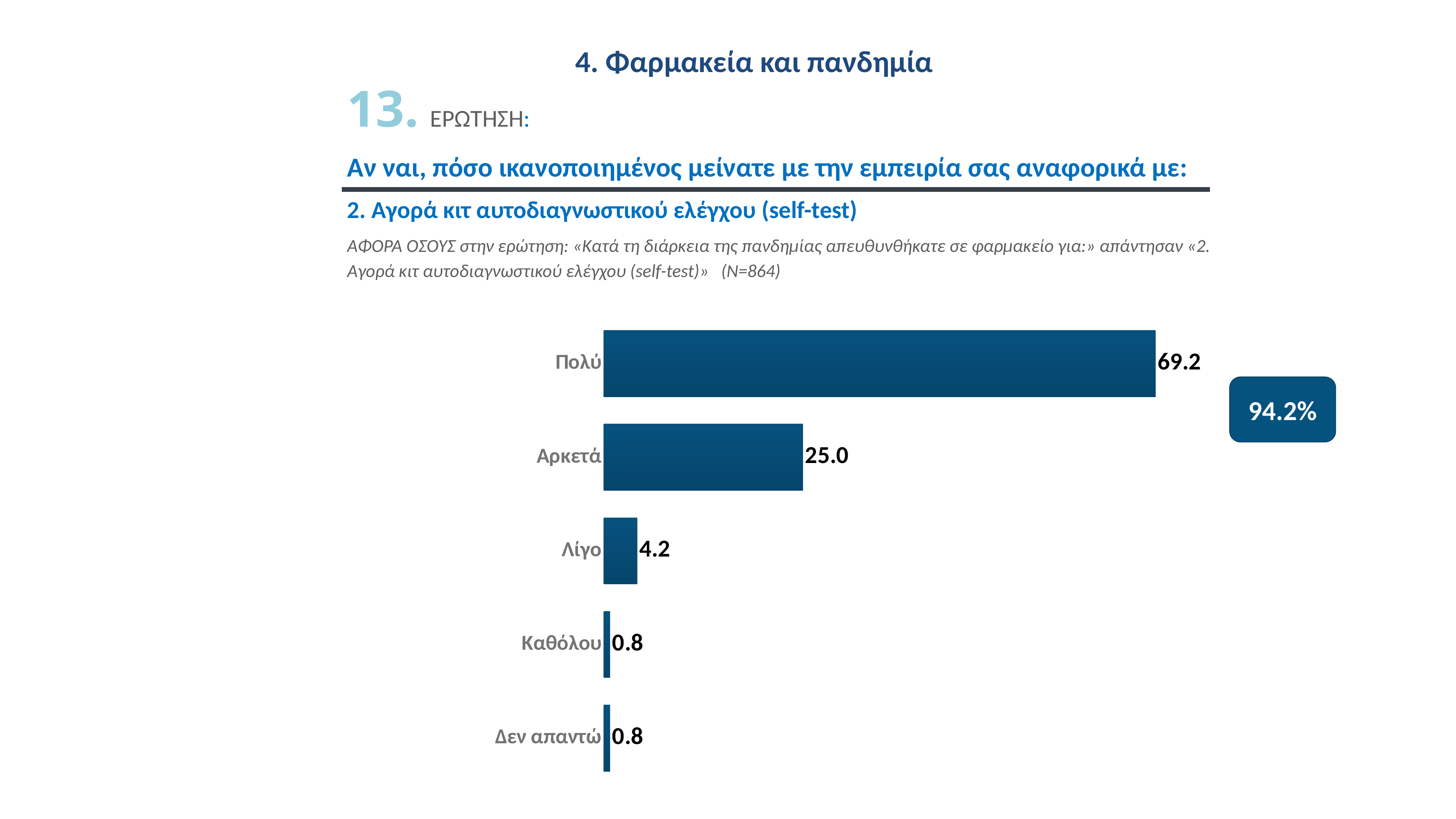
What is the value for Πολύ? 69.2 What is the value for Λίγο? 4.2 Which category has the highest value? Πολύ What is the value for Αρκετά? 25.0 Which is larger, the value for Αρκετά or the value for Λίγο? Αρκετά How many categories are shown in the chart? 5 What is the value for Δεν απαντώ? 0.8 What is the combined value of Πολύ and Αρκετά? 94.2 What kind of chart is shown on the slide? Bar chart What is the value for Καθόλου? 0.8 What percentage is shown in the rounded box to the right of the chart? 94.2% What is the difference between the values for Πολύ and Αρκετά? 44.2